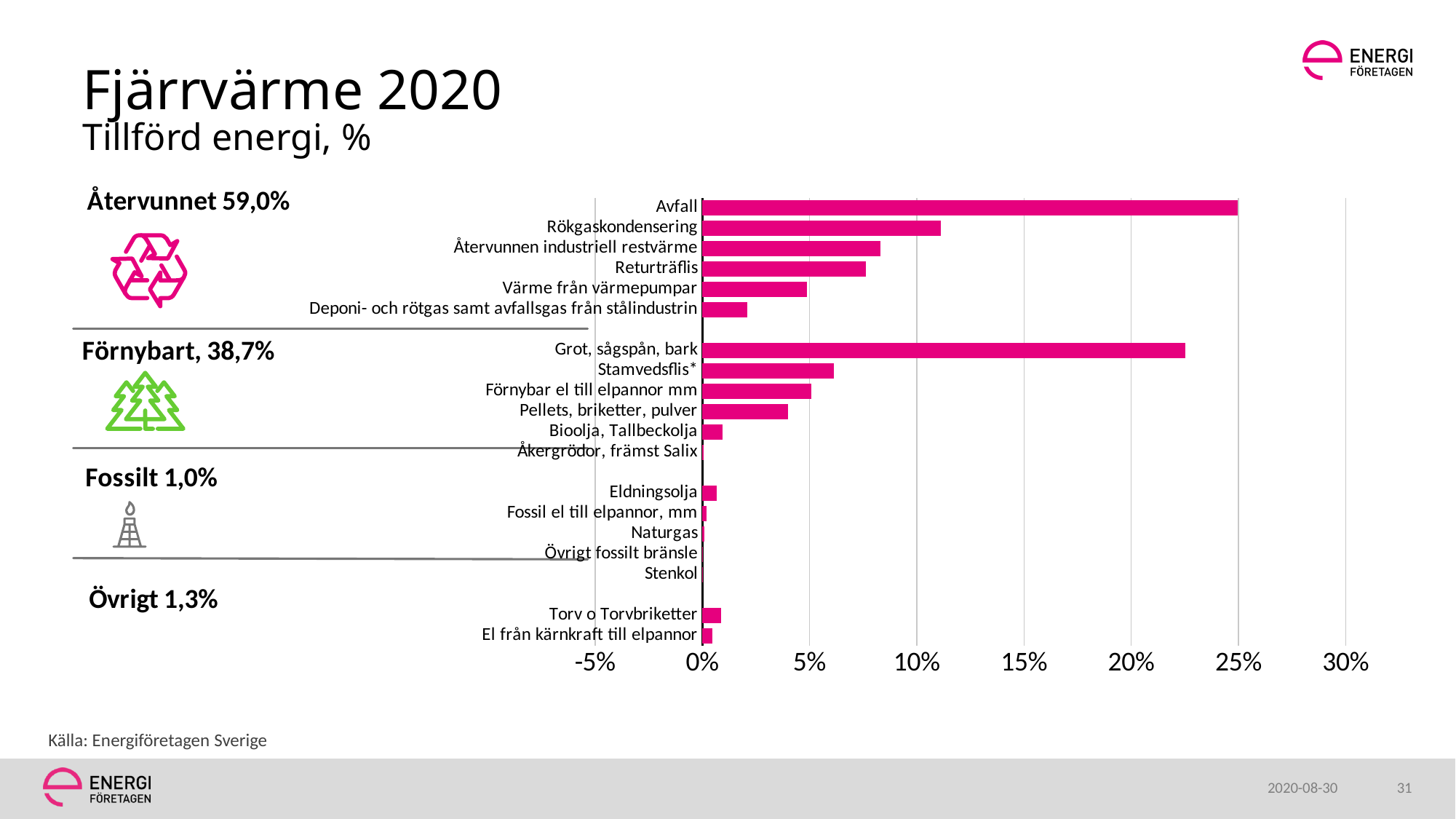
Is the value for Grot, sågspån, bark greater or less than 20%? greater Which is larger, the value for Avfall or the value for Grot, sågspån, bark? Avfall Is the value for Pellets, briketter, pulver greater or less than 5%? less Which is larger, the value for Rökgaskondensering or the value for Returträflis? Rökgaskondensering Is the value for Rökgaskondensering greater or less than 10%? greater Which category has the longest bar in the chart? Avfall Which is larger, the value for Stamvedsflis* or the value for Pellets, briketter, pulver? Stamvedsflis* What is the title of the slide containing the chart? Fjärrvärme 2020 How many categories are plotted in the chart? 19 What kind of chart is shown on the slide? bar chart